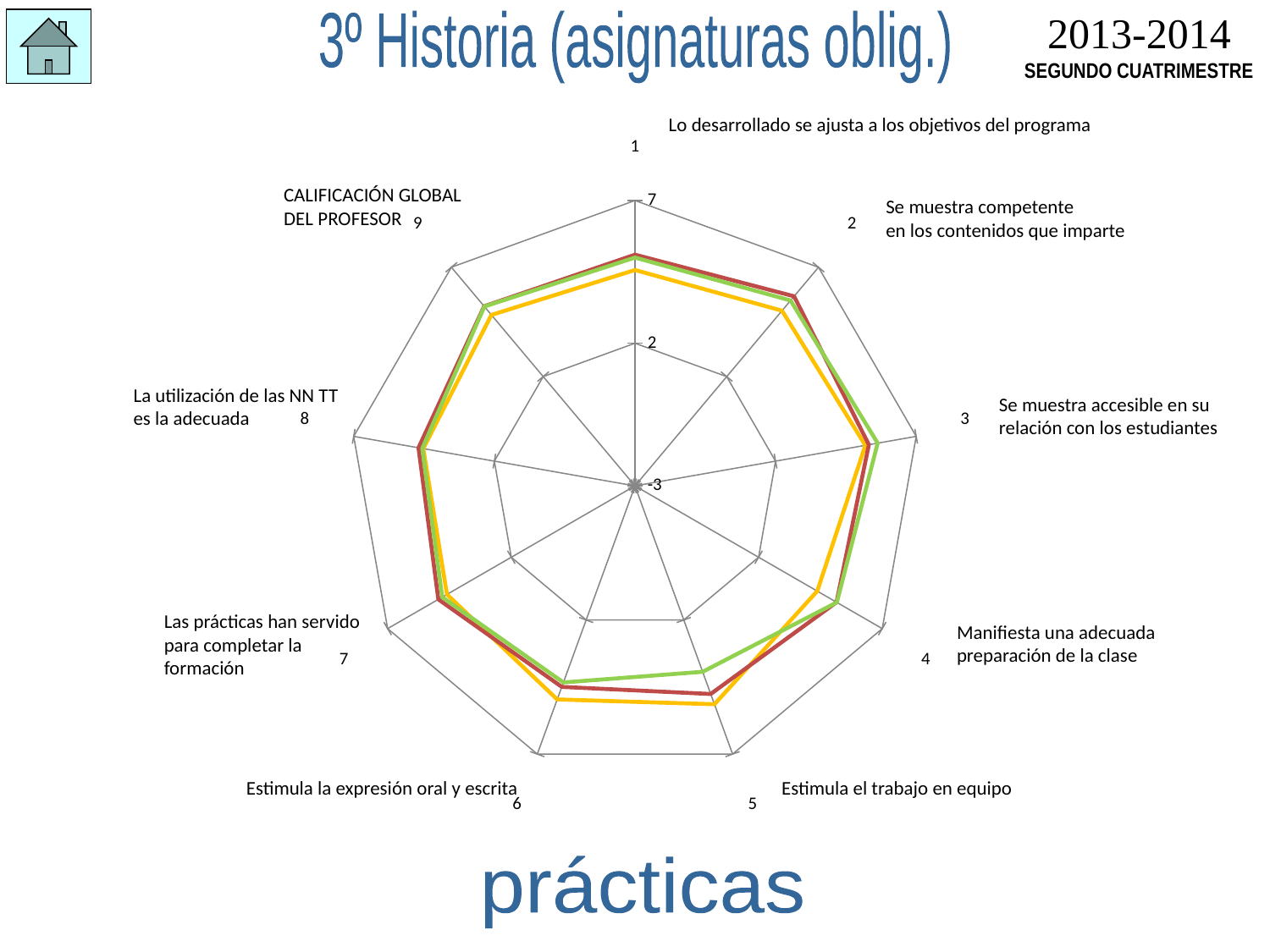
Is the value for 'Se muestra accesible en su relación con los estudiantes' greater or less than 2 for every plotted line? greater Is the value for 'CALIFICACIÓN GLOBAL DEL PROFESOR' on the red line greater or less than 2? greater Is the value for 'Lo desarrollado se ajusta a los objetivos del programa' greater or less than 7 for every plotted line? less What value is shown at the centre of the radar chart's axis? -3 For 'Estimula el trabajo en equipo', which line is lowest: red, green or yellow? green How many categories (axes) does the radar chart have? 9 What is the highest value shown on the radar chart's axis scale? 7 Which category is labelled with the number 8 on the radar chart? La utilización de las NN TT es la adecuada For 'Estimula la expresión oral y escrita', which line is higher: the yellow line or the green line? yellow What kind of chart is shown on the slide? radar chart For 'Manifiesta una adecuada preparación de la clase', which line is lower: the yellow line or the red line? yellow